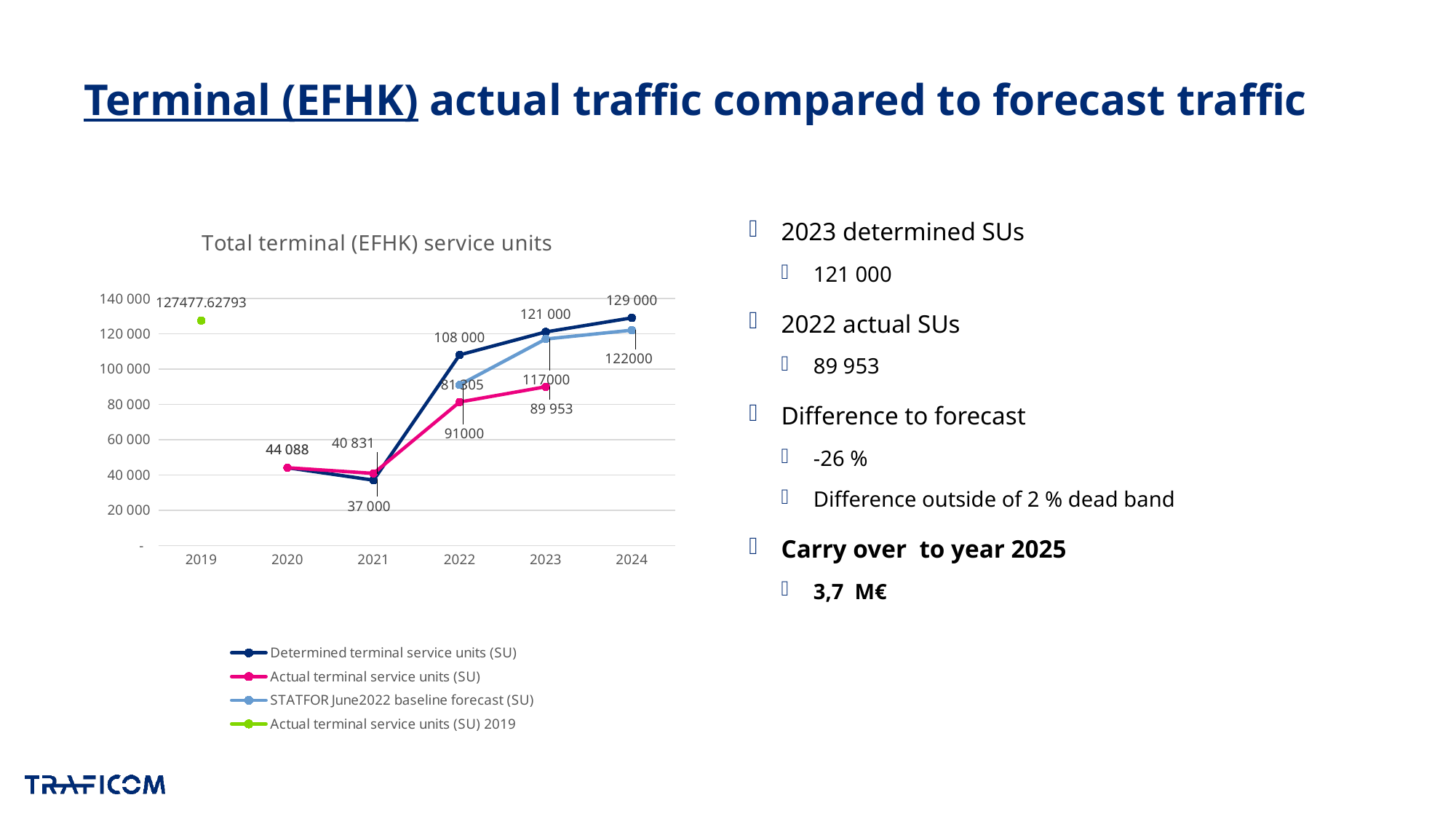
What is the STATFOR June2022 baseline forecast (SU) value for 2024? 122000 What kind of chart is shown on the slide? line chart What is the value of Actual terminal service units (SU) 2019? 127477.62793 How many years are shown on the x axis? 6 What is the value of Determined terminal service units (SU) for 2023? 121 000 What is the difference between the Determined terminal service units and the Actual terminal service units in 2023? 31 047 In which year is the Determined terminal service units (SU) series at its highest? 2024 In 2022, which is larger: the Determined terminal service units or the STATFOR June2022 baseline forecast? Determined terminal service units (SU) What is the value of Determined terminal service units (SU) for 2021? 37 000 How many series does the chart legend list? 4 What is the value of Actual terminal service units (SU) for 2022? 81 305 What is the title of the chart? Total terminal (EFHK) service units